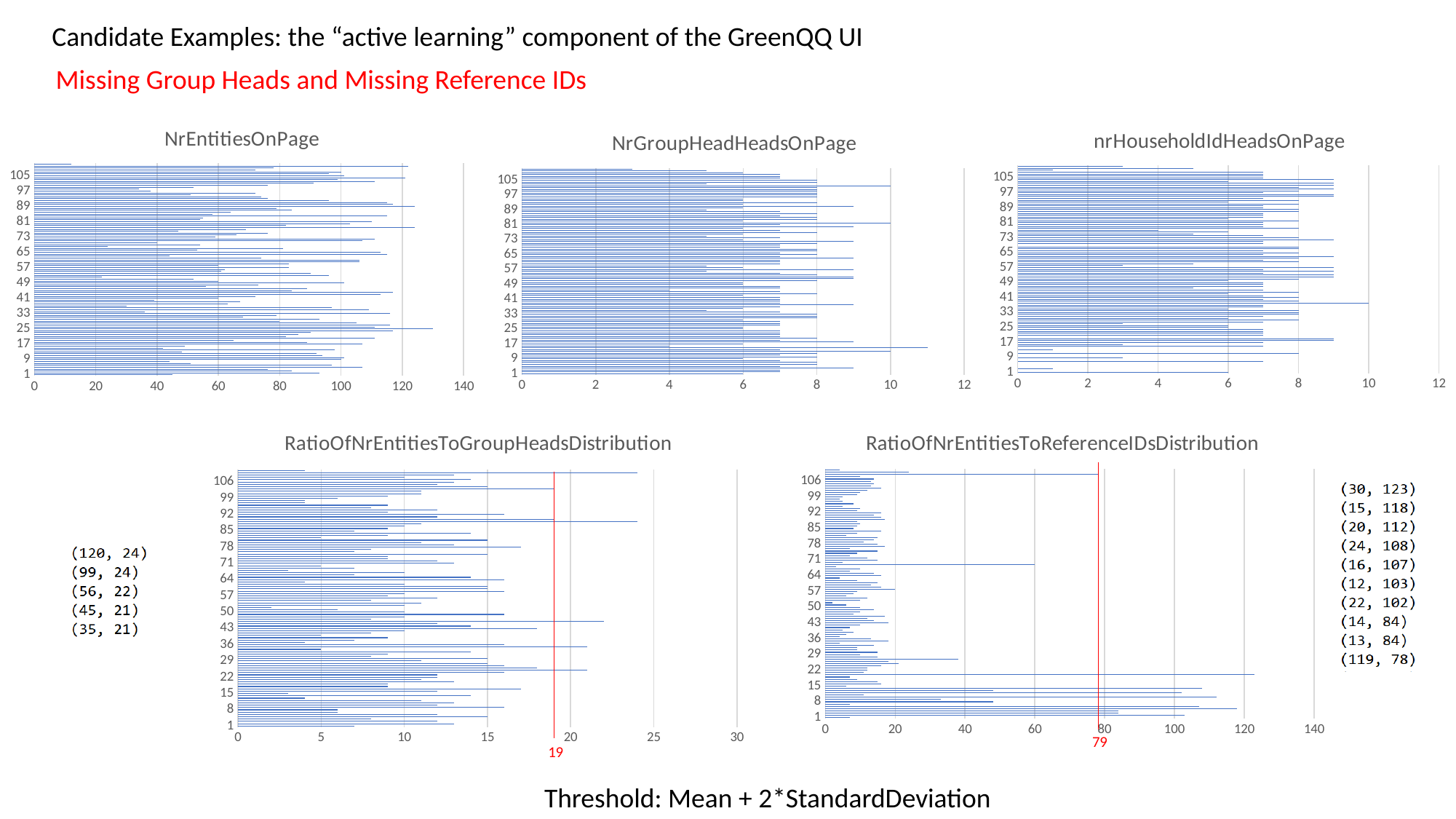
How many charts are shown on the slide? 5 In the nrHouseholdIdHeadsOnPage chart, is the value of the longest bar greater or less than 8? greater In the NrEntitiesOnPage chart, is the value of the longest bar greater or less than 120? greater In the RatioOfNrEntitiesToGroupHeadsDistribution chart, what threshold value is marked in red below the x axis? 19 According to the text at the bottom of the slide, how is the threshold computed? Mean + 2*StandardDeviation Which chart on the slide has an x axis that extends to 30? RatioOfNrEntitiesToGroupHeadsDistribution In the RatioOfNrEntitiesToReferenceIDsDistribution chart, what threshold value is marked in red below the x axis? 79 In the NrGroupHeadHeadsOnPage chart, is the value of the longest bar greater or less than 10? greater What kind of chart is NrEntitiesOnPage? bar chart